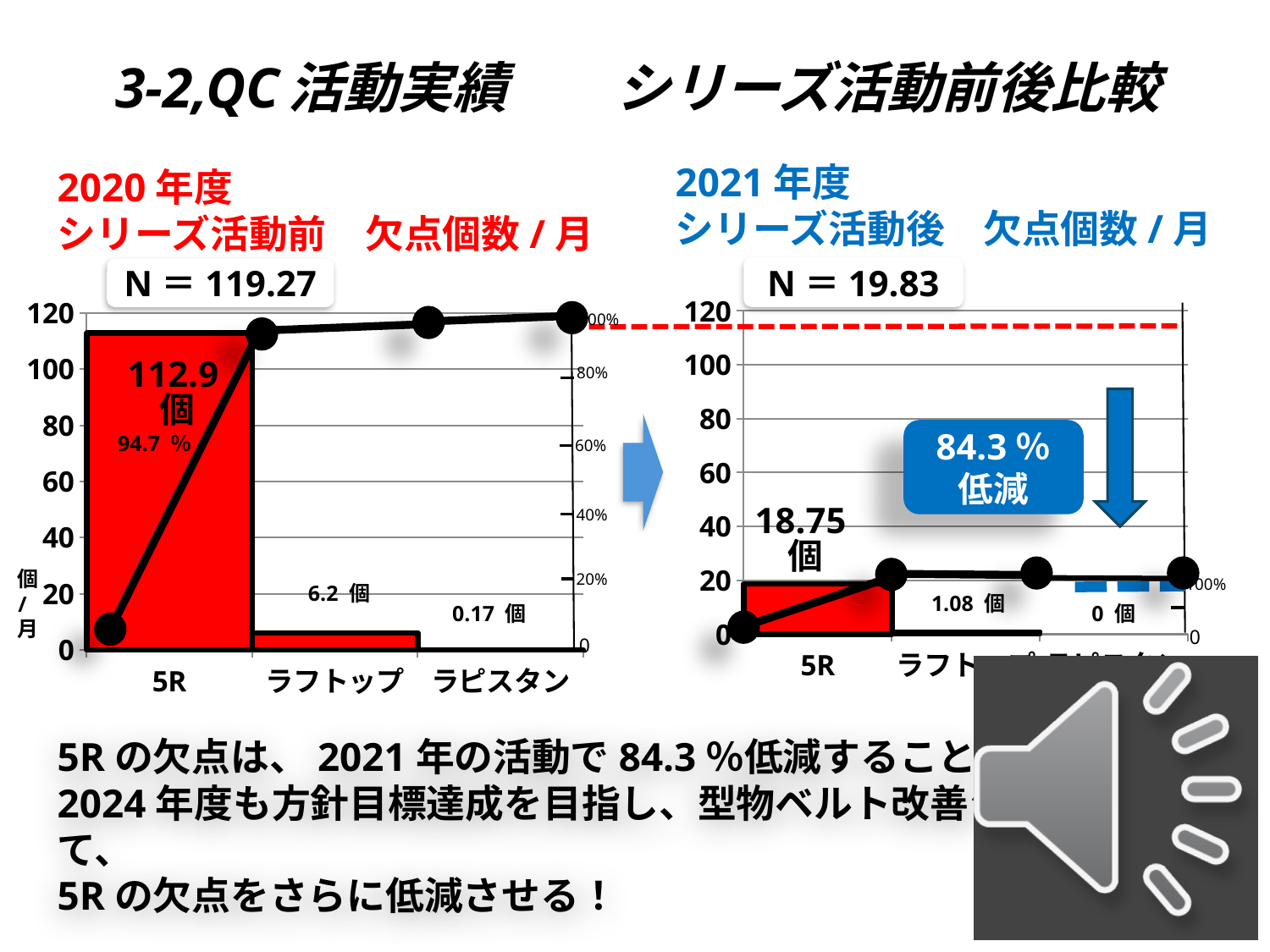
In the 2021年度 シリーズ活動後 chart on the right, what is the value for ラピスタン? 0 個 What is the difference between the 5R value in the 2020年度 chart on the left and the 5R value in the 2021年度 chart on the right? 94.15 個 How many categories are shown on the x axis of the 2021年度 シリーズ活動後 chart on the right? 3 In the 2020年度 シリーズ活動前 chart on the left, which category has the highest value? 5R In the 2020年度 シリーズ活動前 chart on the left, what cumulative percentage is shown for 5R? 94.7 % In the 2021年度 シリーズ活動後 chart on the right, what is the value for 5R? 18.75 個 In the 2020年度 シリーズ活動前 chart on the left, what is the value for ラピスタン? 0.17 個 What is the N value shown above the 2020年度 シリーズ活動前 chart on the left? N ＝ 119.27 In the 2020年度 シリーズ活動前 chart on the left, what is the value for 5R? 112.9 個 In the 2021年度 シリーズ活動後 chart on the right, which category has the lowest value? ラピスタン In the 2021年度 シリーズ活動後 chart on the right, what is the value for ラフトップ? 1.08 個 In the 2020年度 シリーズ活動前 chart on the left, what is the value for ラフトップ? 6.2 個